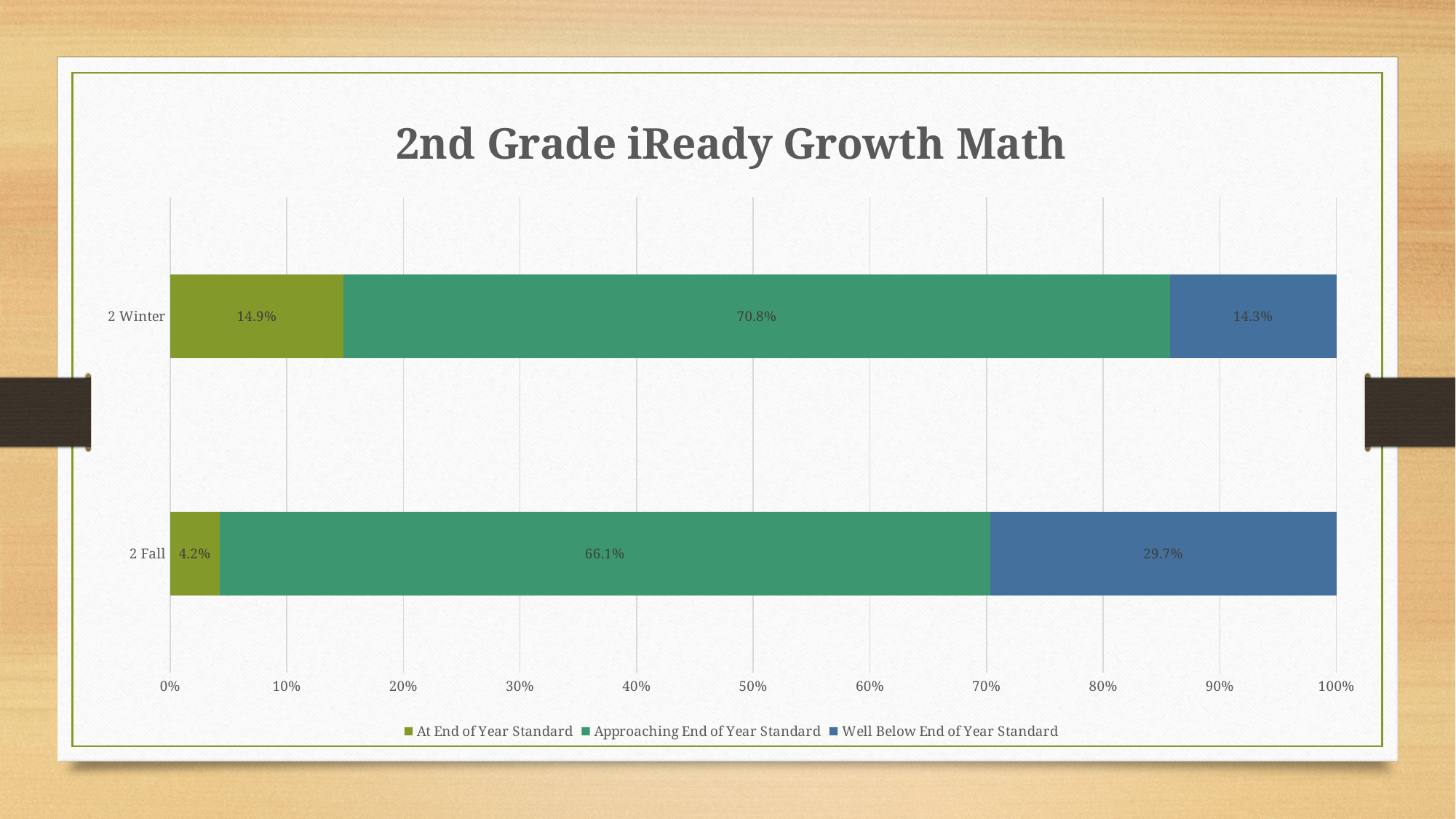
What is the value for Well Below End of Year Standard in 2 Winter? 14.3% What is the difference between the At End of Year Standard values for 2 Winter and 2 Fall? 10.7% How many categories are shown on the chart? 2 What is the difference between the Well Below End of Year Standard values for 2 Fall and 2 Winter? 15.4% What kind of chart is shown on the slide? Stacked bar chart How many series does the legend list? 3 What is the title of the chart? 2nd Grade iReady Growth Math What is the value for At End of Year Standard in 2 Winter? 14.9% What is the value for Approaching End of Year Standard in 2 Fall? 66.1% Which category has the higher value for At End of Year Standard, 2 Winter or 2 Fall? 2 Winter What is the value for Well Below End of Year Standard in 2 Fall? 29.7% Which category has the lowest value for Well Below End of Year Standard? 2 Winter